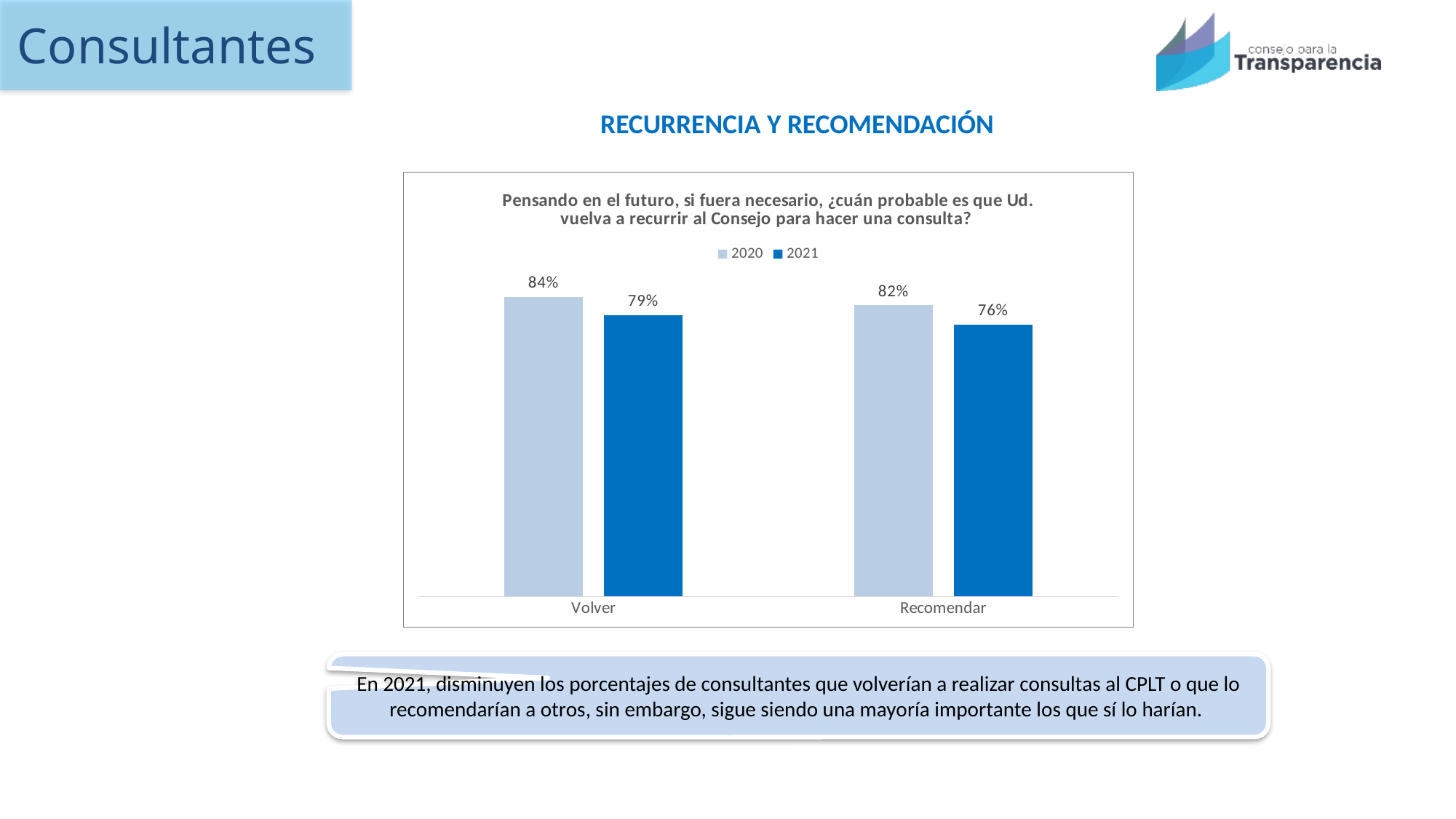
What is the value for Recomendar in 2021? 76% What kind of chart is shown on the slide? Bar chart What is the difference between the 2020 and 2021 values for Volver? 5% Which category has the highest value in the 2021 series? Volver What is the value for Volver in 2021? 79% How many categories are shown on the x axis? 2 What is the difference between the 2020 and 2021 values for Recomendar? 6% Which is larger for Recomendar: the 2020 value or the 2021 value? 2020 Which category has the lowest value in the 2020 series? Recomendar How many series does the legend list? 2 What is the value for Recomendar in 2020? 82% What is the value for Volver in 2020? 84%